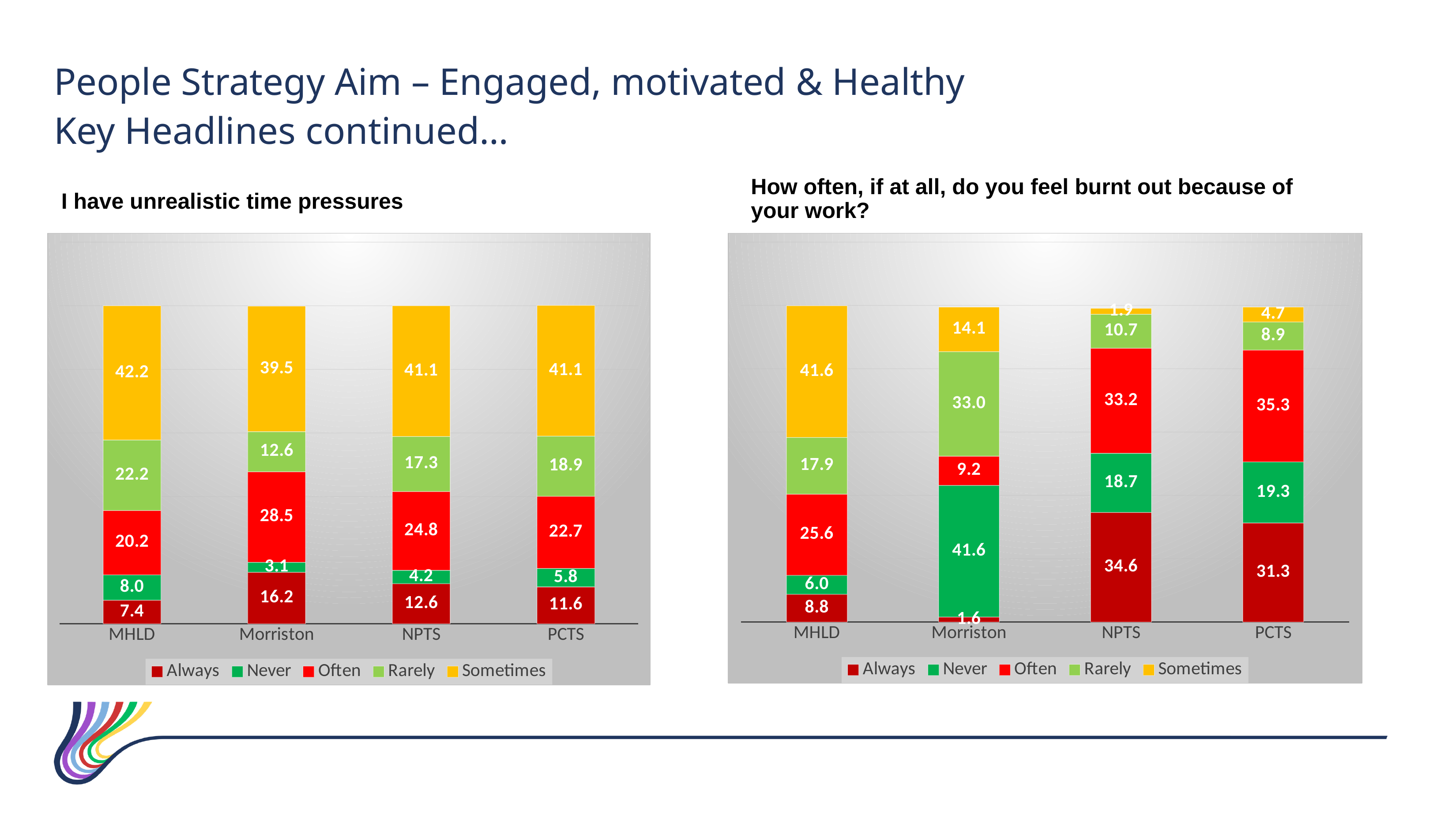
In the 'How often, if at all, do you feel burnt out because of your work?' chart, what is the difference between the Always values for NPTS and PCTS? 3.3 In the 'I have unrealistic time pressures' chart, what is the Sometimes value for MHLD? 42.2 How many series does the legend of the 'I have unrealistic time pressures' chart list? 5 In the 'I have unrealistic time pressures' chart, which category has the highest Always value? Morriston In the 'How often, if at all, do you feel burnt out because of your work?' chart, is the Sometimes value larger for MHLD or Morriston? MHLD What type of chart is the 'How often, if at all, do you feel burnt out because of your work?' chart? Stacked bar chart In the 'I have unrealistic time pressures' chart, what is the difference between the Rarely values for MHLD and Morriston? 9.6 In the 'I have unrealistic time pressures' chart, what is the Often value for Morriston? 28.5 In the 'How often, if at all, do you feel burnt out because of your work?' chart, what is the Never value for Morriston? 41.6 In the 'How often, if at all, do you feel burnt out because of your work?' chart, which category has the highest Often value? PCTS In the 'How often, if at all, do you feel burnt out because of your work?' chart, what is the Always value for NPTS? 34.6 In the 'I have unrealistic time pressures' chart, which category has the lowest Never value? Morriston